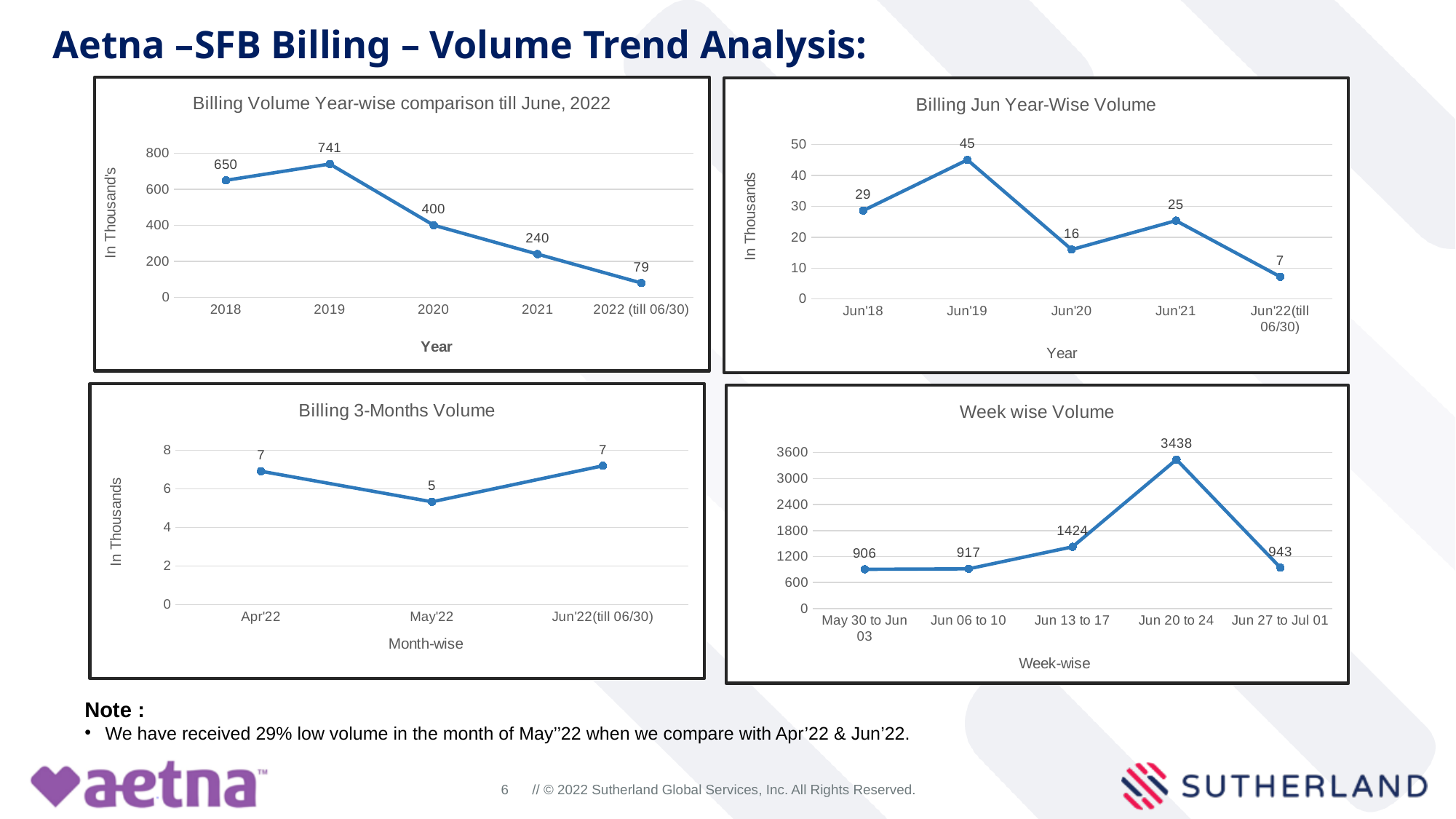
In the 'Billing Jun Year-Wise Volume' chart, what is the value for Jun'20? 16 In the 'Billing Volume Year-wise comparison till June, 2022' chart, what is the difference between the 2019 and 2020 values? 341 In the 'Week wise Volume' chart, what is the value for Jun 20 to 24? 3438 In the 'Week wise Volume' chart, which week has the lowest value? May 30 to Jun 03 In the 'Billing Jun Year-Wise Volume' chart, which year has the highest value? Jun'19 In the 'Billing Volume Year-wise comparison till June, 2022' chart, what is the value for 2019? 741 What type of chart is the 'Week wise Volume' chart? line chart In the 'Week wise Volume' chart, what is the difference between the Jun 20 to 24 and Jun 27 to Jul 01 values? 2495 In the 'Billing 3-Months Volume' chart, what is the value for May'22? 5 In the 'Billing Jun Year-Wise Volume' chart, how many data points are plotted? 5 In the 'Billing 3-Months Volume' chart, is the value for Apr'22 larger or smaller than the value for May'22? larger In the 'Billing Volume Year-wise comparison till June, 2022' chart, which year has the lowest value? 2022 (till 06/30)